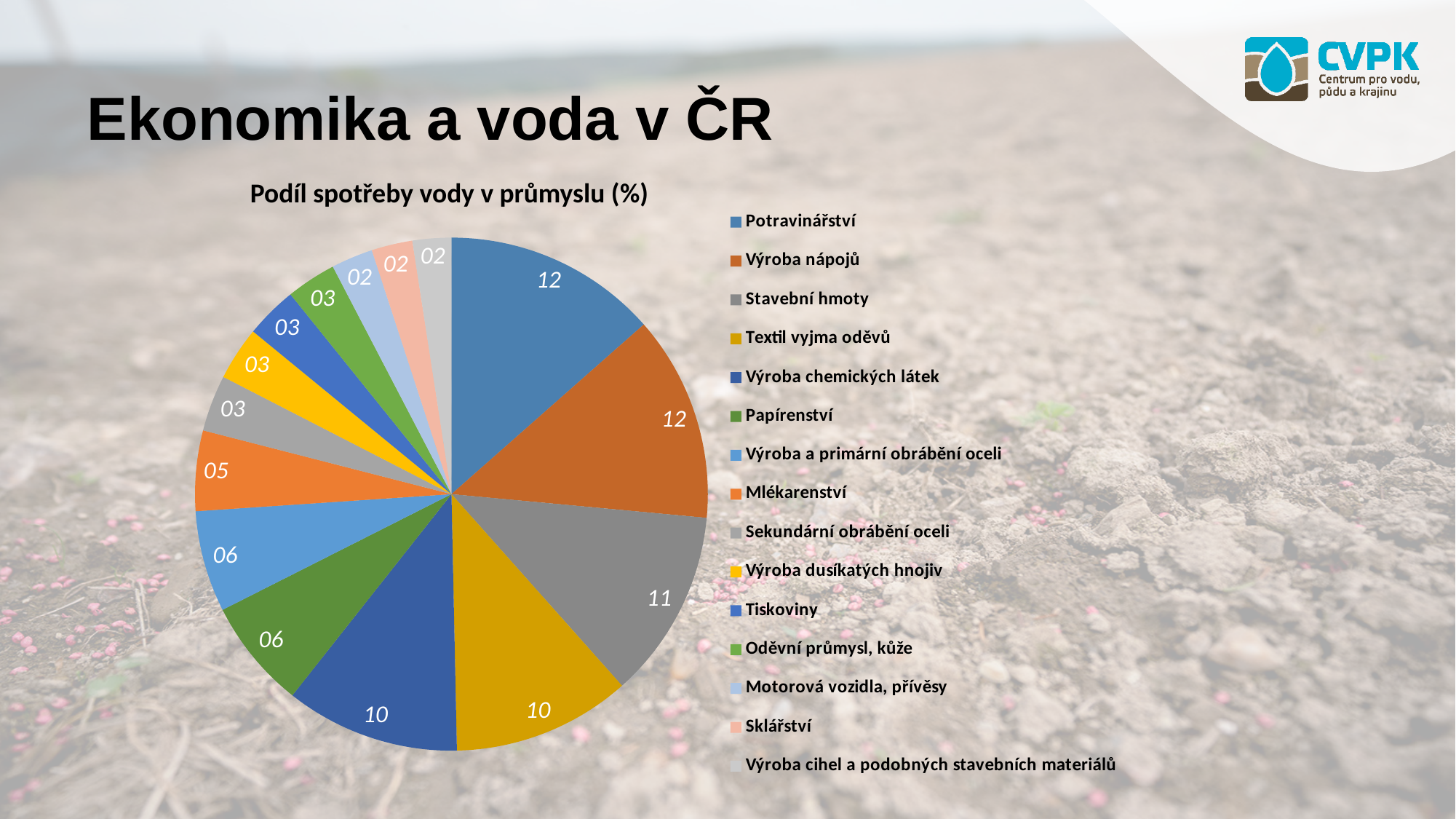
What value is shown for Textil vyjma oděvů? 10 How many entries does the legend list? 15 How many slices does the pie chart have? 15 What value is shown for Sklářství? 02 What value is shown for Mlékarenství? 05 Which is larger, the value for Stavební hmoty or the value for Mlékarenství? Stavební hmoty What is the difference between the value for Výroba nápojů and the value for Mlékarenství? 7 What value is shown for Stavební hmoty? 11 What kind of chart is shown on the slide? pie chart What is the title of the chart? Podíl spotřeby vody v průmyslu (%) What value is shown for Potravinářství? 12 What colour is the slice for Výroba dusíkatých hnojiv? yellow